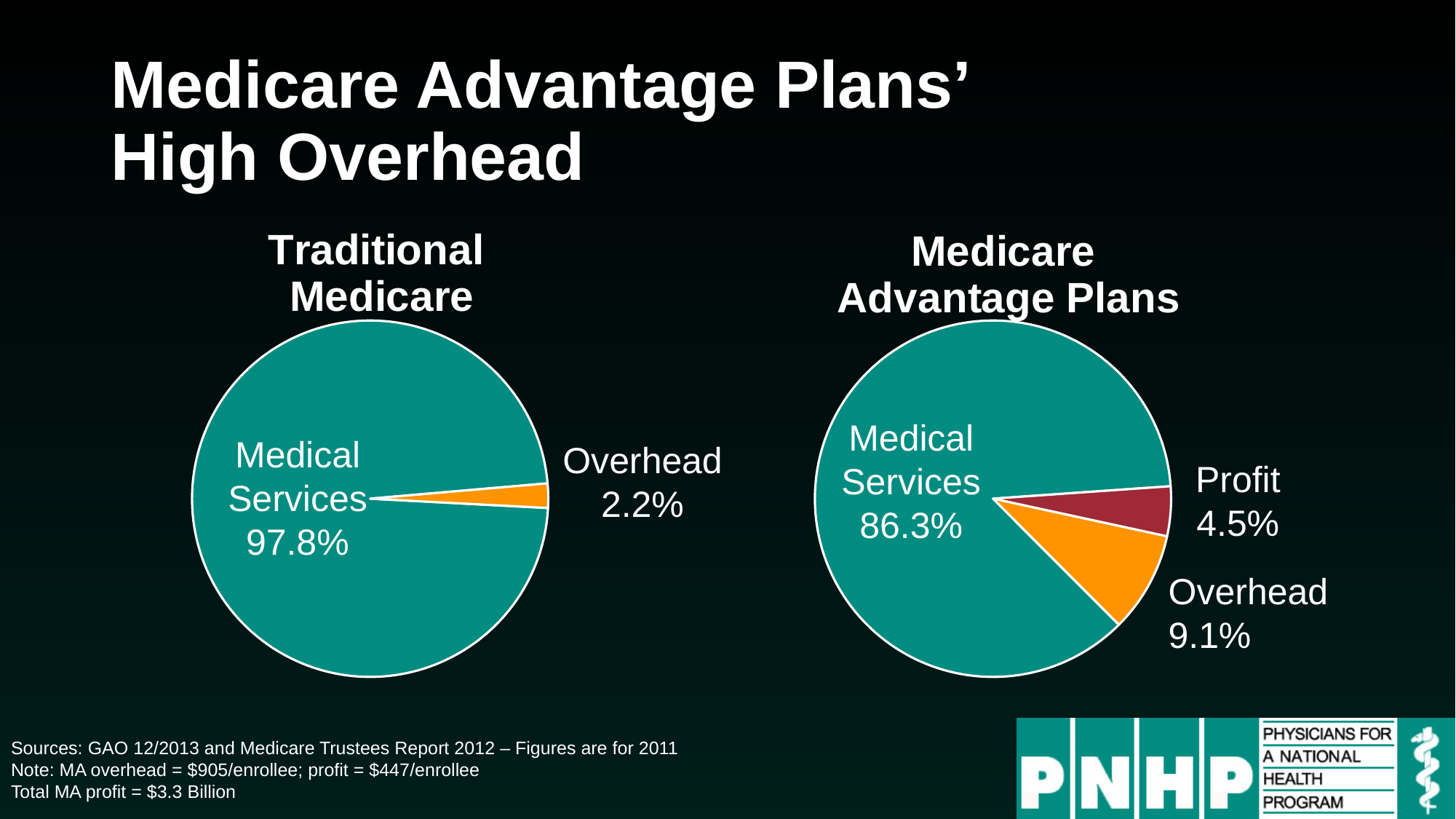
What is the difference between the Overhead share in the Medicare Advantage Plans chart and the Overhead share in the Traditional Medicare chart? 6.9% Which chart has the larger Overhead share, Traditional Medicare or Medicare Advantage Plans? Medicare Advantage Plans In the Medicare Advantage Plans chart, which slice is the largest? Medical Services In the Medicare Advantage Plans chart, what share goes to Profit? 4.5% In the Medicare Advantage Plans chart, which slice is the smallest? Profit In the Medicare Advantage Plans chart, what share goes to Overhead? 9.1% In the Traditional Medicare chart, what share goes to Overhead? 2.2% In the Medicare Advantage Plans chart, how many slices does the pie have? 3 In the Traditional Medicare chart, how many slices does the pie have? 2 What type of chart is used for the Traditional Medicare chart? Pie chart In the Traditional Medicare chart, what share goes to Medical Services? 97.8% In the Medicare Advantage Plans chart, what share goes to Medical Services? 86.3%